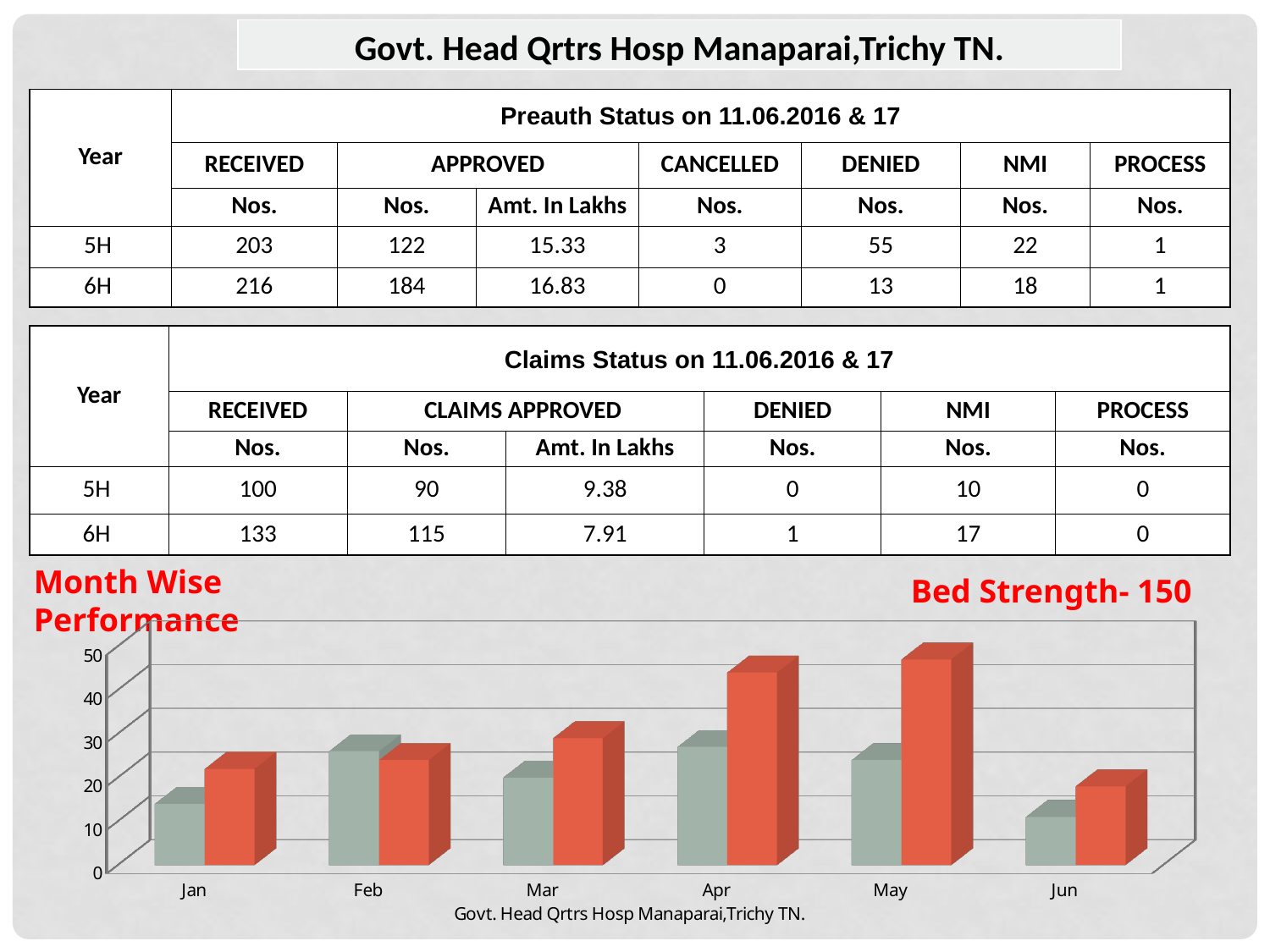
In the bar chart, which month has the tallest red bar? May In the bar chart, which is larger for Jan, the red bar or the grey bar? the red bar What kind of chart is shown at the bottom of the slide? bar chart Is the grey bar for Feb in the bar chart greater or less than 20? greater In the bar chart, which month has the shortest red bar? Jun What title is printed below the x axis of the bar chart? Govt. Head Qrtrs Hosp Manaparai,Trichy TN. How many months are shown on the x axis of the bar chart? 6 Is the grey bar for Apr in the bar chart greater or less than 20? greater In the bar chart, which is larger for Apr, the red bar or the grey bar? the red bar Is the grey bar for Jan in the bar chart greater or less than 20? less